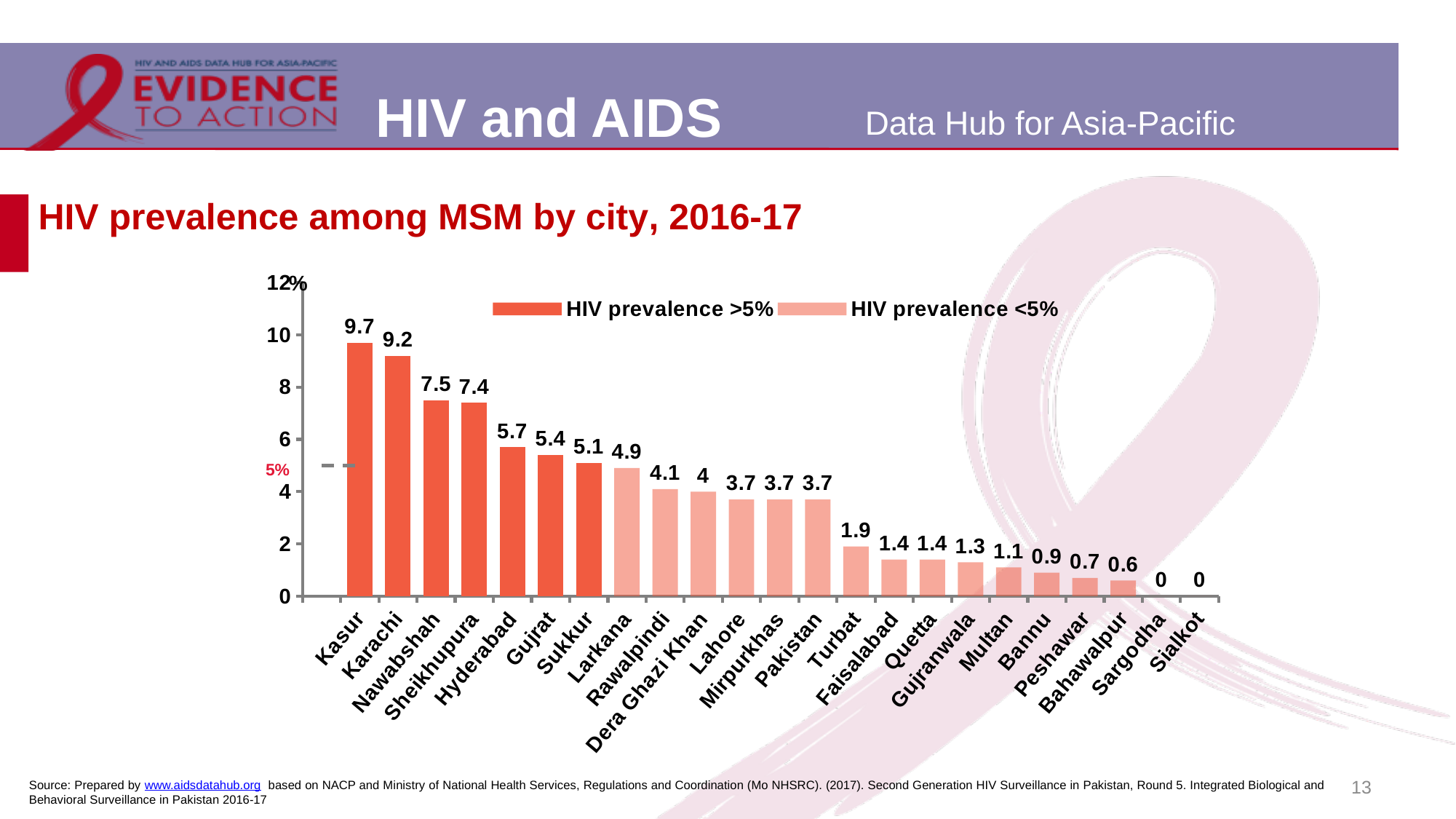
What are the two legend entries of the chart? HIV prevalence >5% and HIV prevalence <5% What is the HIV prevalence among MSM in Kasur? 9.7 Which has a higher HIV prevalence, Nawabshah or Sukkur? Nawabshah What kind of chart is shown on the slide? Bar chart What is the difference between the values for Hyderabad and Turbat? 3.8 What is the HIV prevalence among MSM in Larkana? 4.9 How many cities/categories are shown on the x axis? 23 How many series does the legend list? 2 Which has a higher HIV prevalence, Rawalpindi or Multan? Rawalpindi What is the difference between the values for Kasur and Karachi? 0.5 What is the value shown for Pakistan overall? 3.7 Which city has the highest HIV prevalence among MSM? Kasur